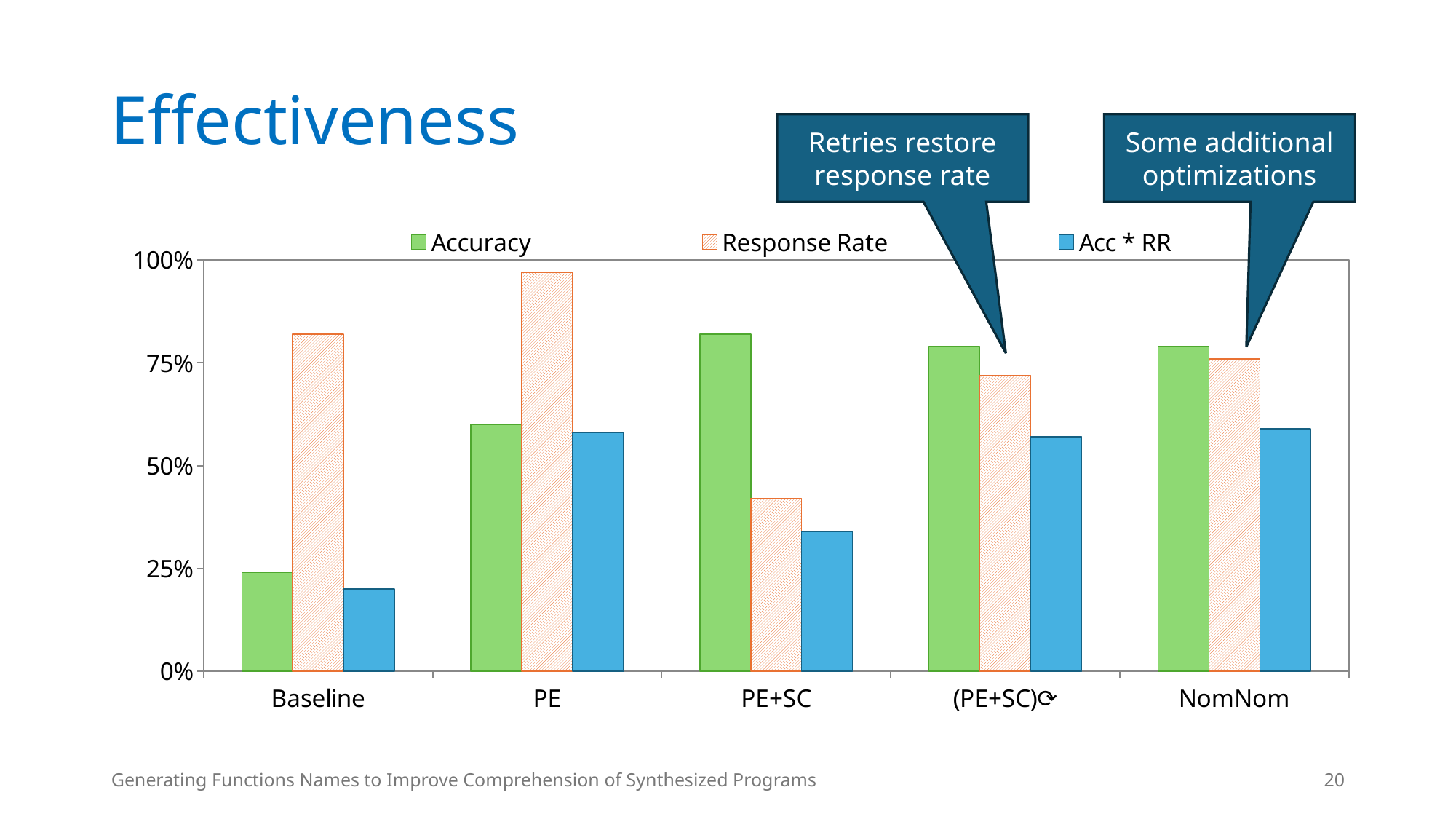
For PE+SC, which is larger: Accuracy or Response Rate? Accuracy How many categories are shown along the x axis? 5 Is the Acc * RR value for PE+SC greater or less than 50%? less How many series does the legend list? 3 Is the Accuracy for PE greater or less than 50%? greater Which category has the highest Response Rate? PE What is the title of the slide containing the chart? Effectiveness Is the Response Rate for Baseline greater or less than 75%? greater Does Accuracy rise or fall from Baseline to PE to PE+SC? rise Which category has the lowest Response Rate? PE+SC What kind of chart is shown on the slide? bar chart Which category has the lowest Accuracy? Baseline